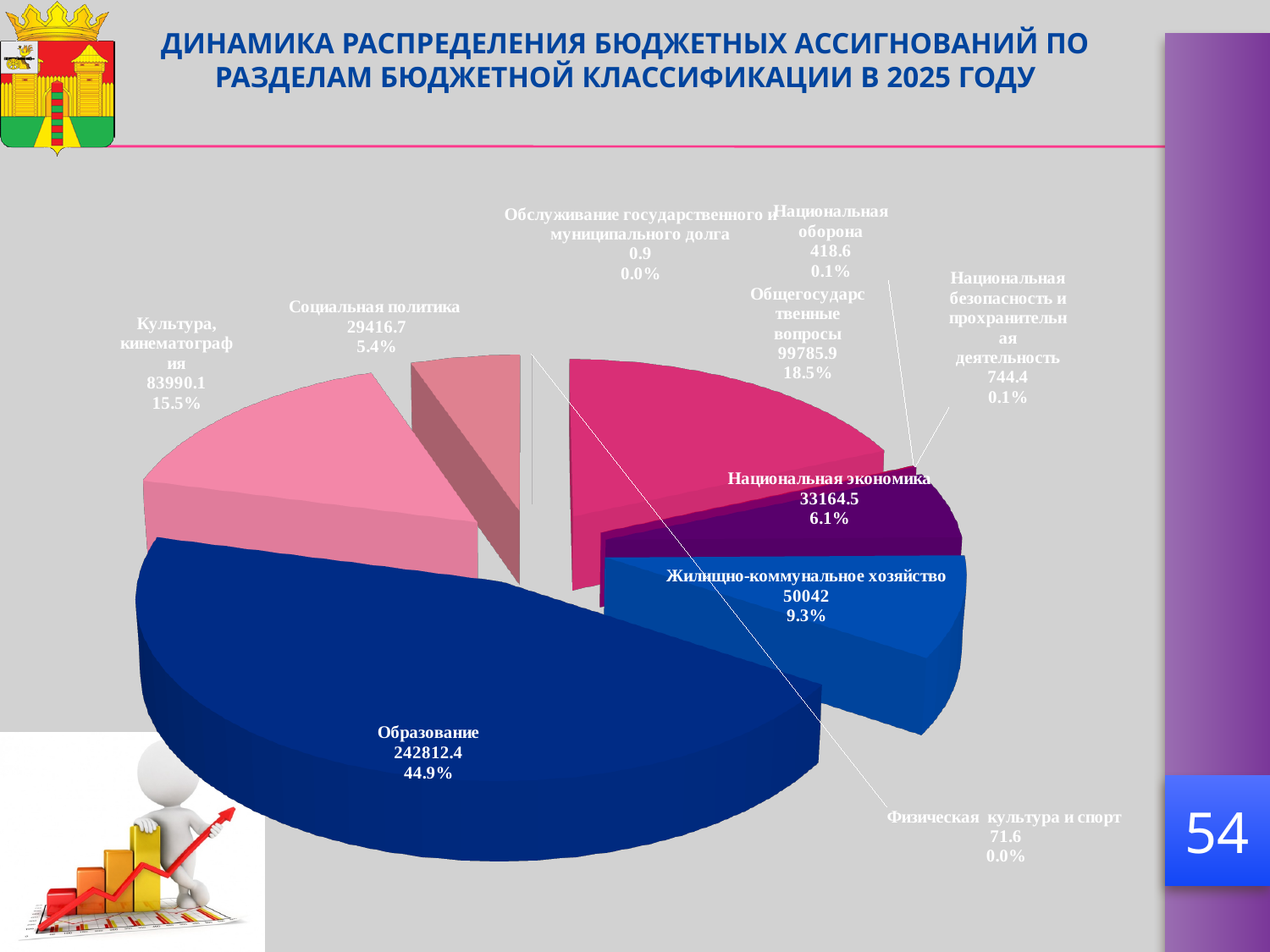
Which category has the smallest value? Обслуживание государственного и муниципального долга What share of the pie does Национальная оборона represent? 0.1% Which category has the largest share of the pie? Образование What share of the pie does Общегосударственные вопросы represent? 18.5% What is the value for Жилищно-коммунальное хозяйство? 50042 What is the difference between the values for Общегосударственные вопросы and Культура, кинематография? 15795.8 What is the value for Культура, кинематография? 83990.1 How many categories are shown in the pie chart? 10 What share of the pie does Образование represent? 44.9% What is the value for Образование? 242812.4 Which is larger, the value for Национальная экономика or the value for Социальная политика? Национальная экономика What kind of chart is shown on the slide? pie chart